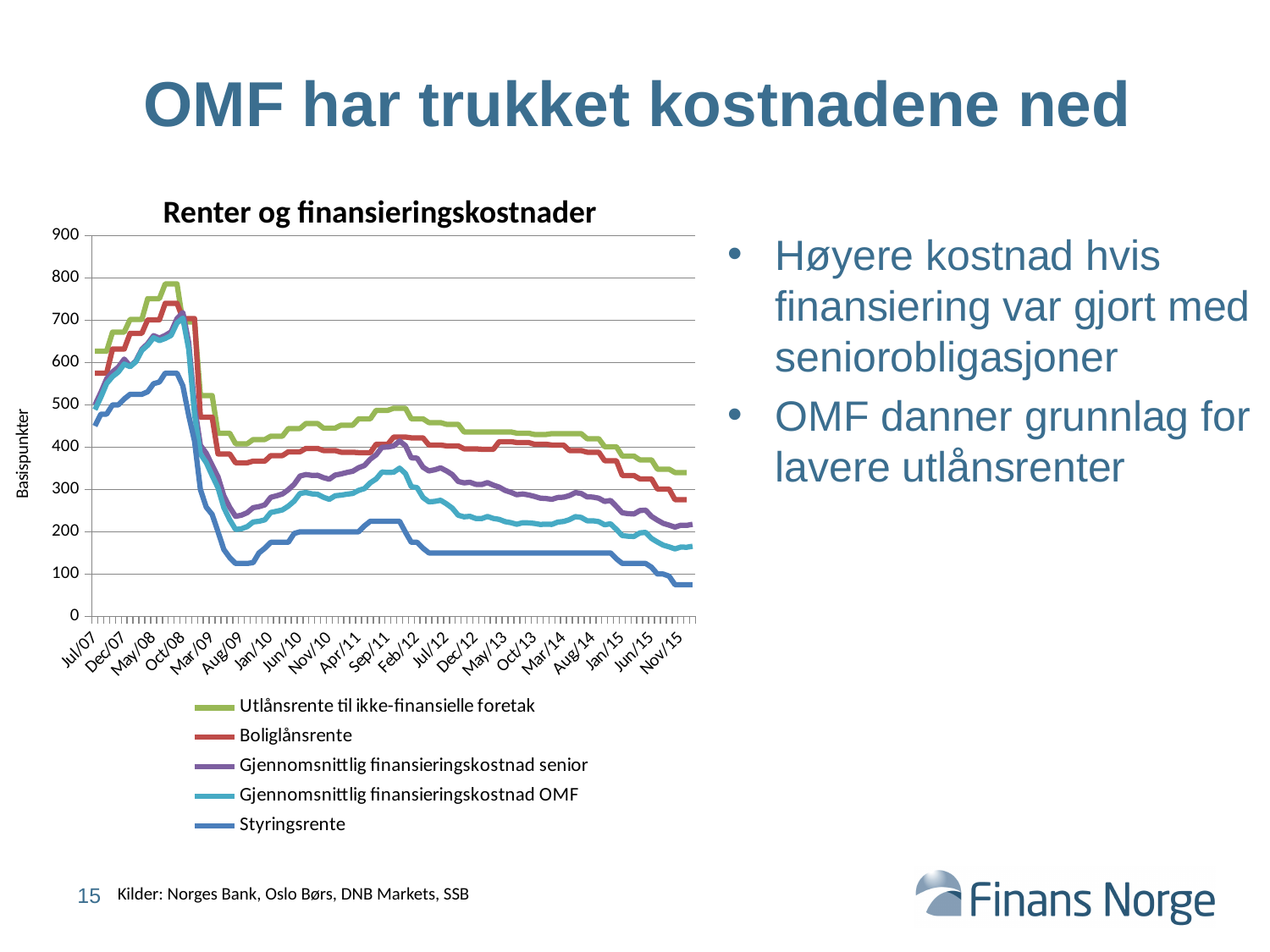
What kind of chart is shown on the slide? line chart What is the label on the vertical axis of the chart? Basispunkter Is the value for Gjennomsnittlig finansieringskostnad OMF at Nov/15 greater or less than 200? less Which series has the lowest value at Nov/15? Styringsrente Is the peak value of Utlånsrente til ikke-finansielle foretak in 2008 greater or less than 700? greater How many series does the legend of the chart list? 5 Is the value for Boliglånsrente at Nov/15 greater or less than 300? less Does the Styringsrente series rise or fall overall from Jul/07 to Nov/15? fall Which series has the highest value at Nov/15? Utlånsrente til ikke-finansielle foretak What is the title of the chart? Renter og finansieringskostnader At Nov/15, which is larger: Gjennomsnittlig finansieringskostnad senior or Gjennomsnittlig finansieringskostnad OMF? Gjennomsnittlig finansieringskostnad senior